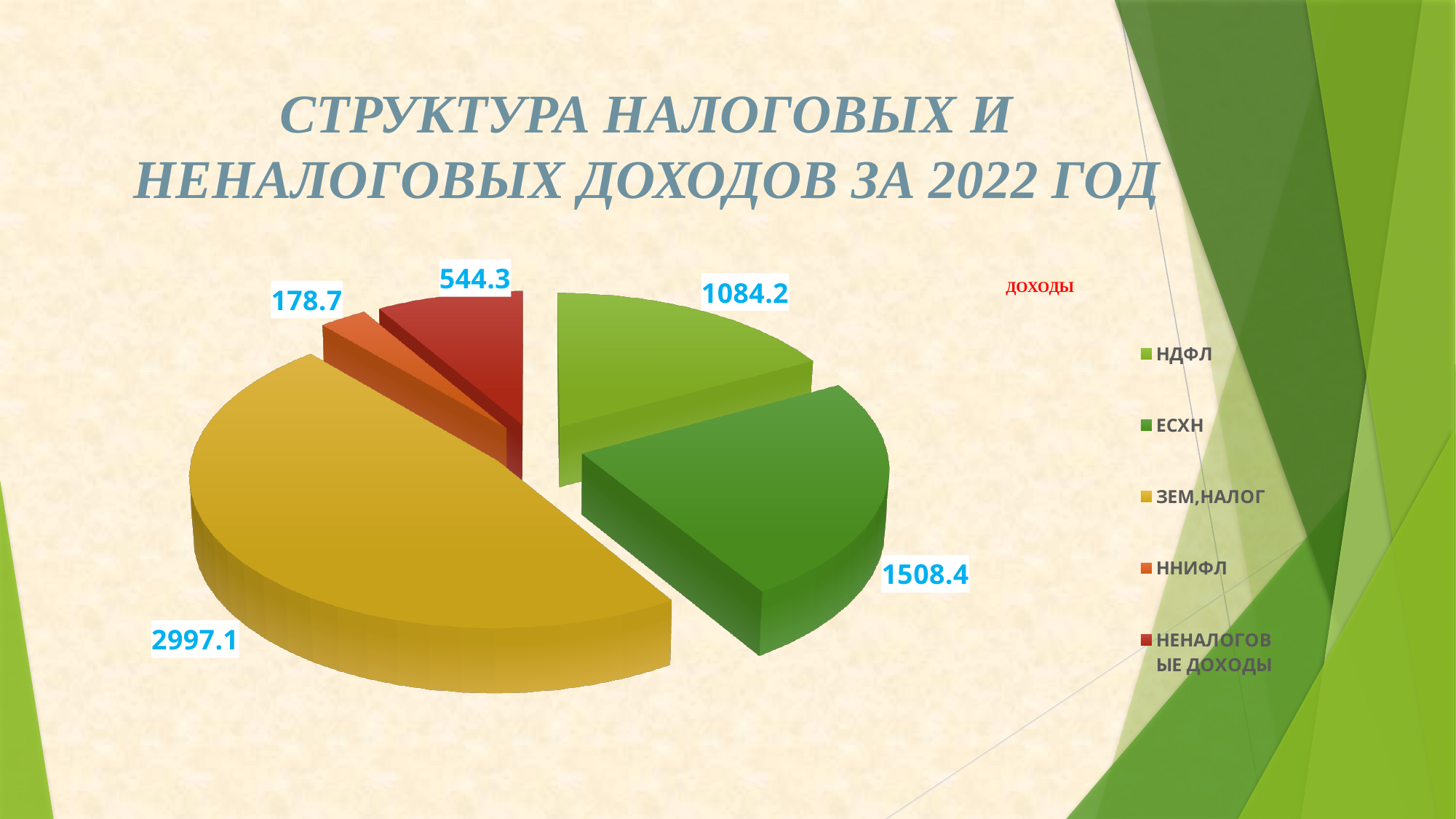
What is the value for НДФЛ? 1084.2 What is the difference between the values for ЗЕМ,НАЛОГ and ЕСХН? 1488.7 What is the value for ЗЕМ,НАЛОГ? 2997.1 What is the value for ННИФЛ? 178.7 Which category has the smallest slice? ННИФЛ What is the title of the chart? ДОХОДЫ What is the value for НЕНАЛОГОВЫЕ ДОХОДЫ? 544.3 What is the value for ЕСХН? 1508.4 Which category has the largest slice? ЗЕМ,НАЛОГ How many categories does the legend list? 5 Which is larger, the value for ЕСХН or the value for НДФЛ? ЕСХН What type of chart is shown on the slide? pie chart